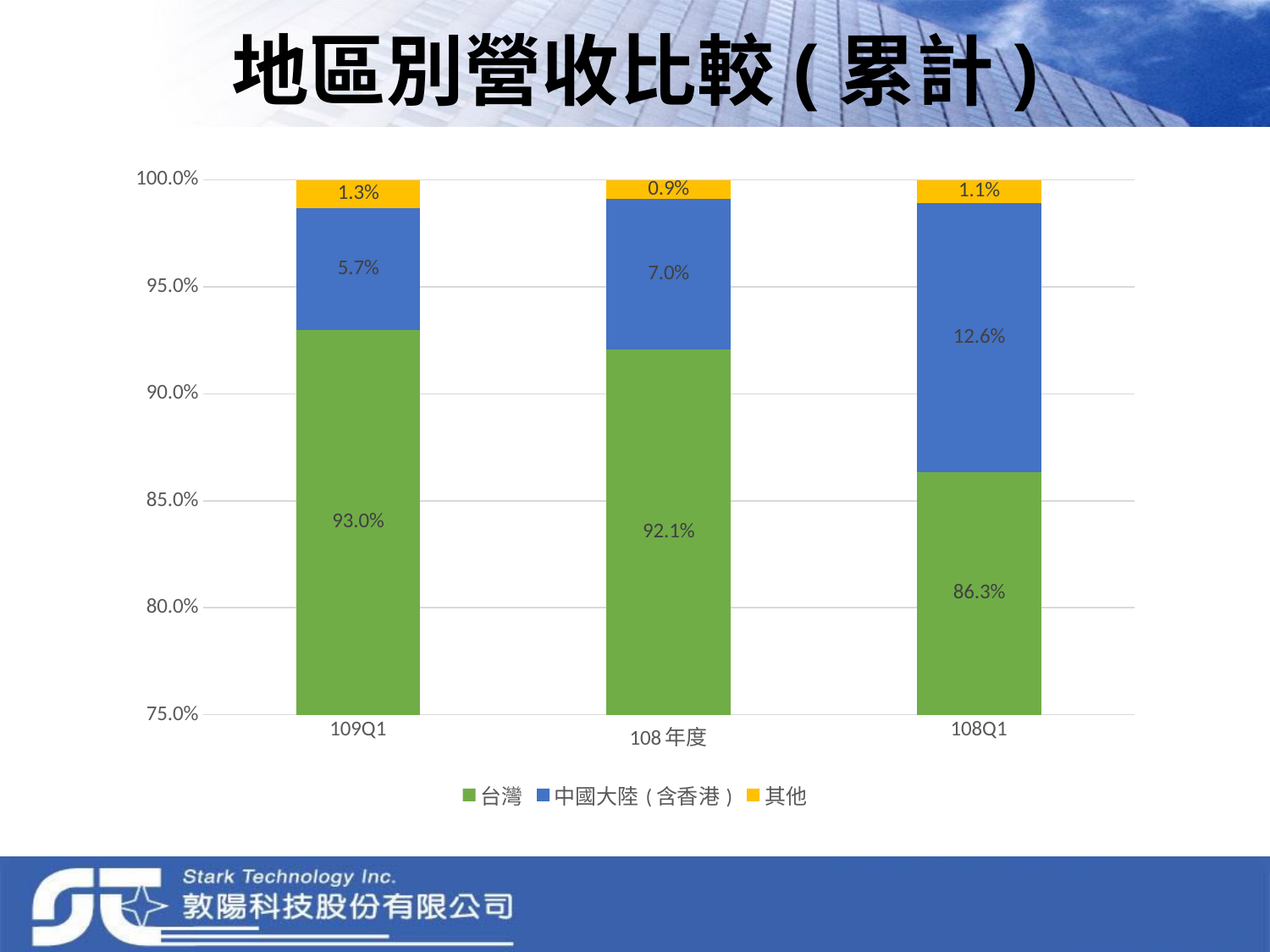
What is the title of the chart? 地區別營收比較（累計） What is the difference between the 台灣 values for 109Q1 and 108Q1? 6.7% What is the value for 中國大陸（含香港） in 108Q1? 12.6% How many series does the legend list? 3 What is the value for 其他 in 108 年度? 0.9% What is the value for 台灣 in 109Q1? 93.0% Which period has the lowest value for 中國大陸（含香港）? 109Q1 What kind of chart is shown on the slide? Stacked bar chart What is the total of the stacked bar for 108Q1? 100.0% Which period has the highest value for 台灣? 109Q1 How many periods are shown on the x axis? 3 Which is larger: the 中國大陸（含香港） value for 108 年度 or for 108Q1? 108Q1